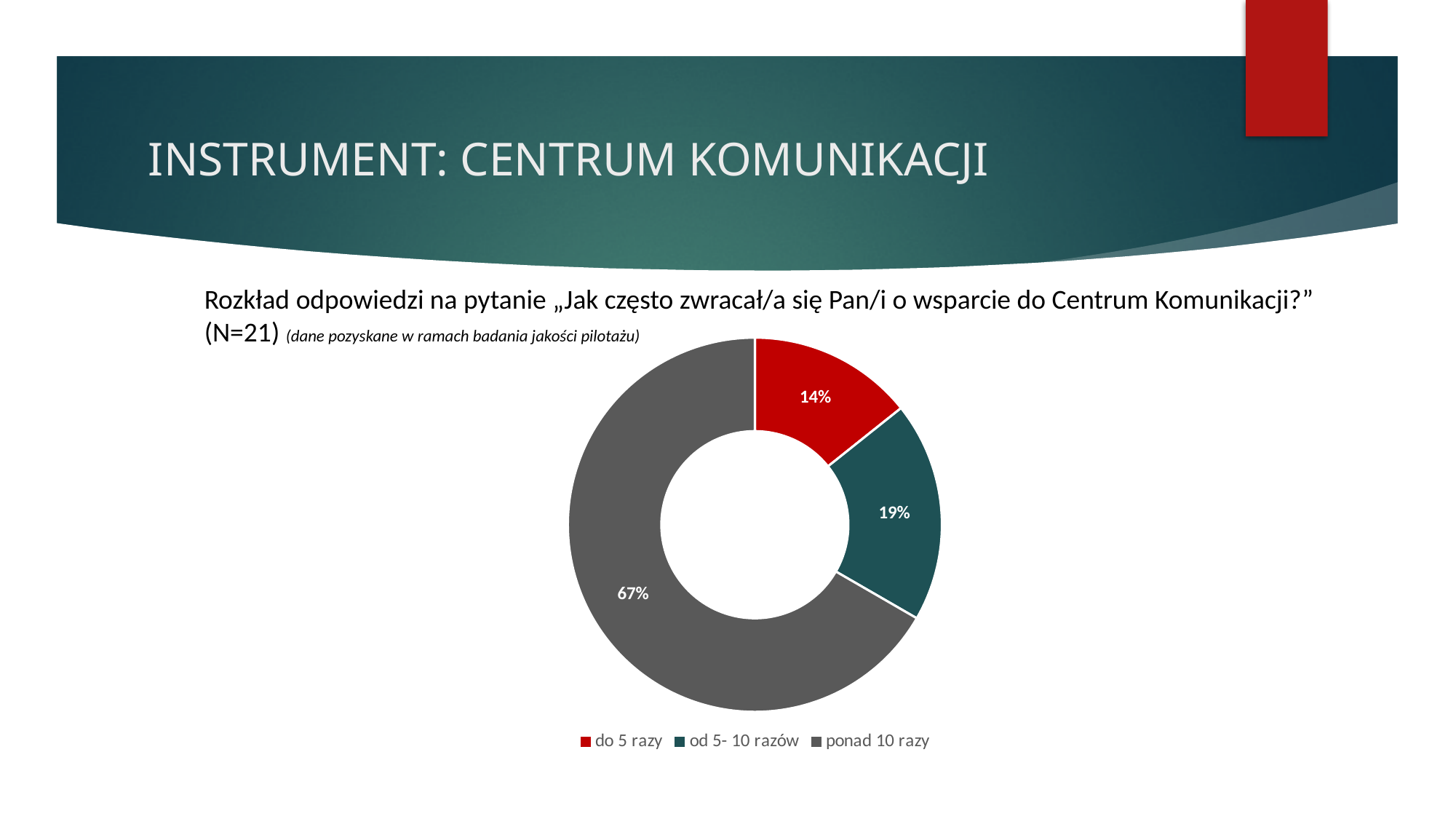
What colour is the "ponad 10 razy" slice? Grey What share of the chart does the "ponad 10 razy" slice represent? 67% How many categories does the chart show? 3 What kind of chart is shown on the slide? Pie chart (doughnut) What share of the chart does the "do 5 razy" slice represent? 14% What share of the chart does the "od 5- 10 razów" slice represent? 19% What is the difference in percentage points between the "ponad 10 razy" and "od 5- 10 razów" slices? 48 Which is larger: the share for "do 5 razy" or the share for "od 5- 10 razów"? od 5- 10 razów Which category has the smallest share of the chart? do 5 razy What is the sample size (N) stated above the chart? 21 What is the difference in percentage points between the "od 5- 10 razów" and "do 5 razy" slices? 5 Which category has the largest share of the chart? ponad 10 razy